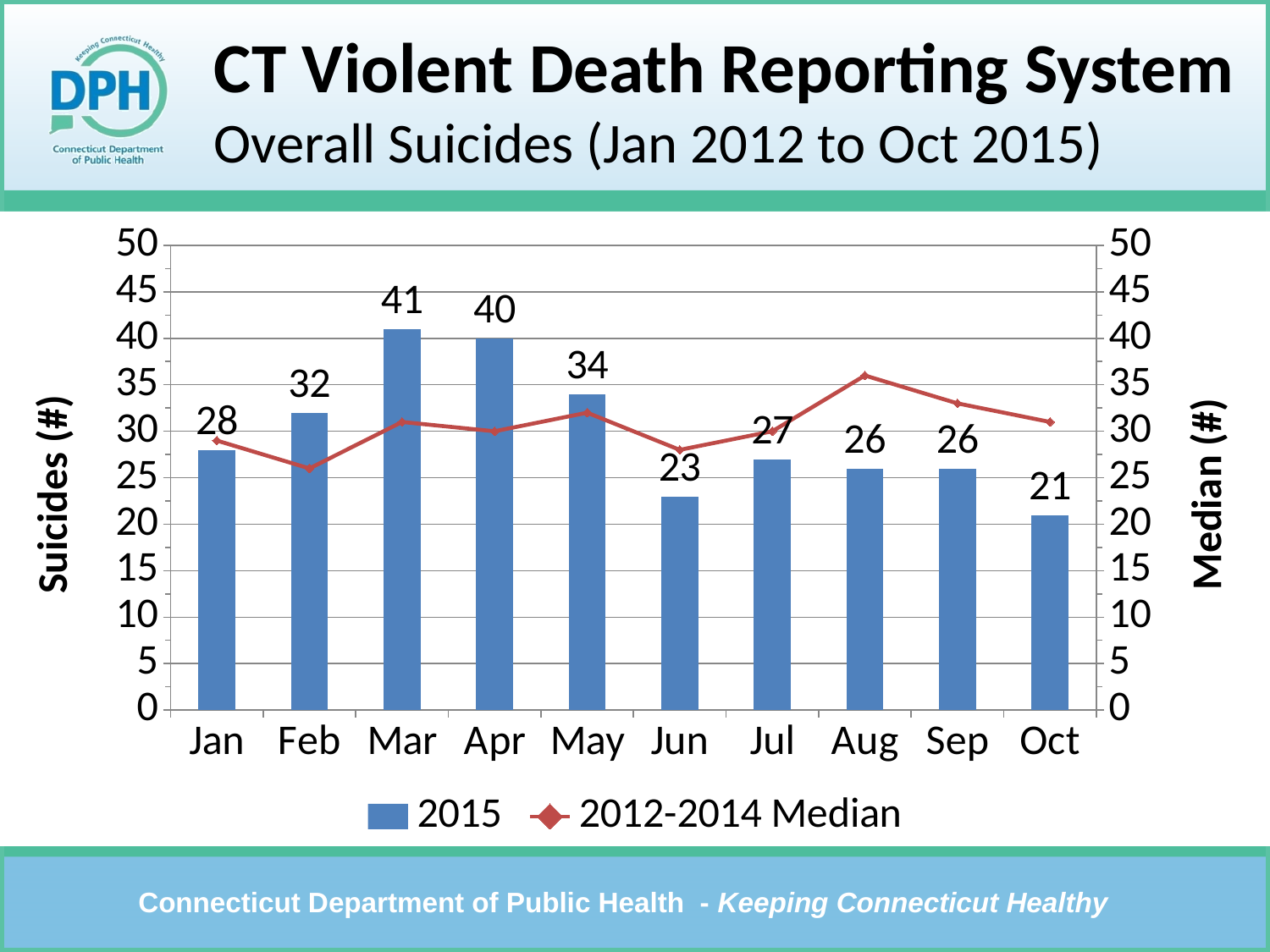
Which month had the lowest number of suicides in 2015? Oct What kind of chart is used to show the 2015 suicide counts? Bar chart Is the 2012-2014 Median value for February greater or less than 30? less Which month had more suicides in 2015, March or April? Mar What was the number of suicides in March 2015? 41 Is the 2012-2014 Median value for August greater or less than 30? greater How many series does the legend list? 2 What is the label of the right-hand vertical axis? Median (#) Which month had the highest number of suicides in 2015? Mar What is the difference between the number of suicides in March 2015 and June 2015? 18 How many months are shown on the x axis? 10 What was the number of suicides in October 2015? 21